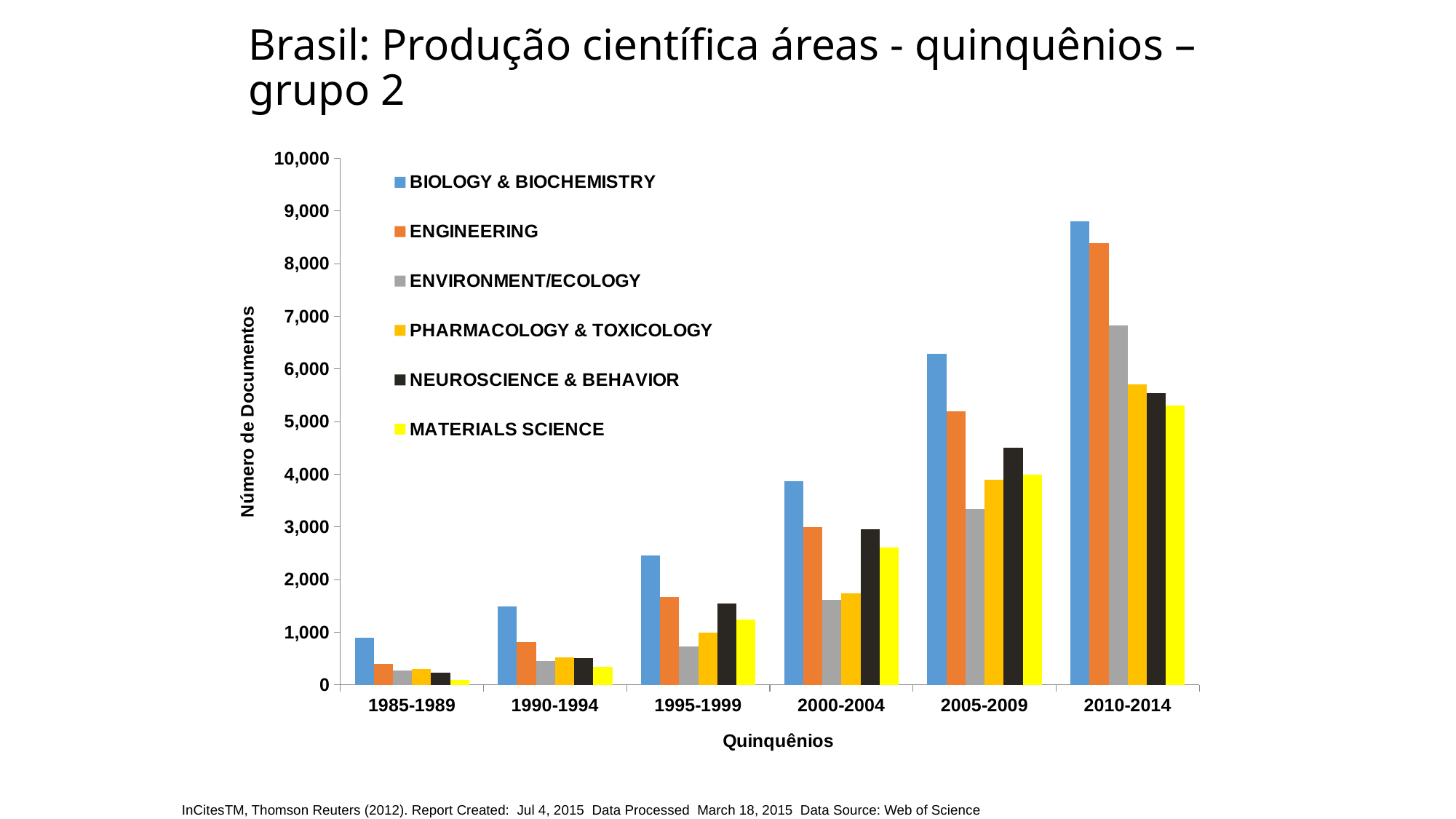
In 2005-2009, which is larger: NEUROSCIENCE & BEHAVIOR or MATERIALS SCIENCE? NEUROSCIENCE & BEHAVIOR What is the title of the vertical axis? Número de Documentos Do the values for BIOLOGY & BIOCHEMISTRY rise or fall from 1985-1989 to 2010-2014? rise Which area has the highest number of documents in 2010-2014? BIOLOGY & BIOCHEMISTRY Is the value for MATERIALS SCIENCE in 2000-2004 greater or less than 3,000? less Which area has the lowest number of documents in 1985-1989? MATERIALS SCIENCE How many quinquênios (periods) are shown on the x axis? 6 What kind of chart is shown on the slide? bar chart Is the value for BIOLOGY & BIOCHEMISTRY in 2010-2014 greater or less than 8,000? greater How many series does the legend list? 6 In which period does ENGINEERING reach its highest value? 2010-2014 Is the value for ENVIRONMENT/ECOLOGY in 2010-2014 greater or less than 6,000? greater